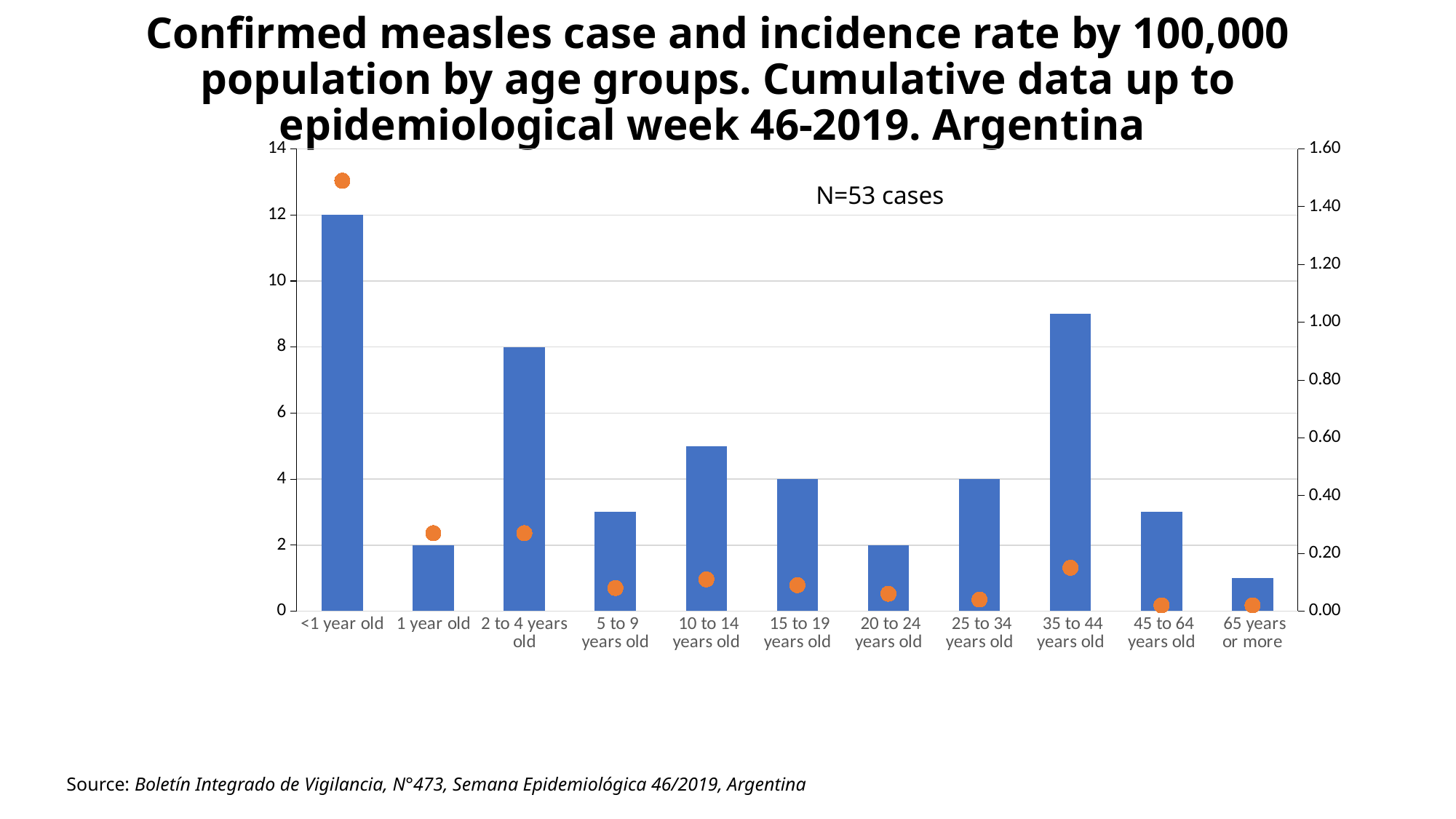
Which age group has the lowest number of confirmed measles cases? 65 years or more How many age groups are shown on the x axis of the chart? 11 Which age group has more confirmed cases, 35 to 44 years old or 10 to 14 years old? 35 to 44 years old Is the number of confirmed cases for the 5 to 9 years old age group greater or less than 4? less What is the difference in confirmed cases between the <1 year old and 2 to 4 years old age groups? 4 How many confirmed measles cases are shown for the 20 to 24 years old age group? 2 What total number of cases does the annotation on the chart state? N=53 cases Which age group has the highest number of confirmed measles cases? <1 year old Is the incidence rate (orange dot, right axis) for the <1 year old age group greater or less than 1.00? greater Is the number of confirmed cases for the 35 to 44 years old age group greater or less than 8? greater How many confirmed measles cases are shown for the <1 year old age group? 12 How many confirmed measles cases are shown for the 2 to 4 years old age group? 8